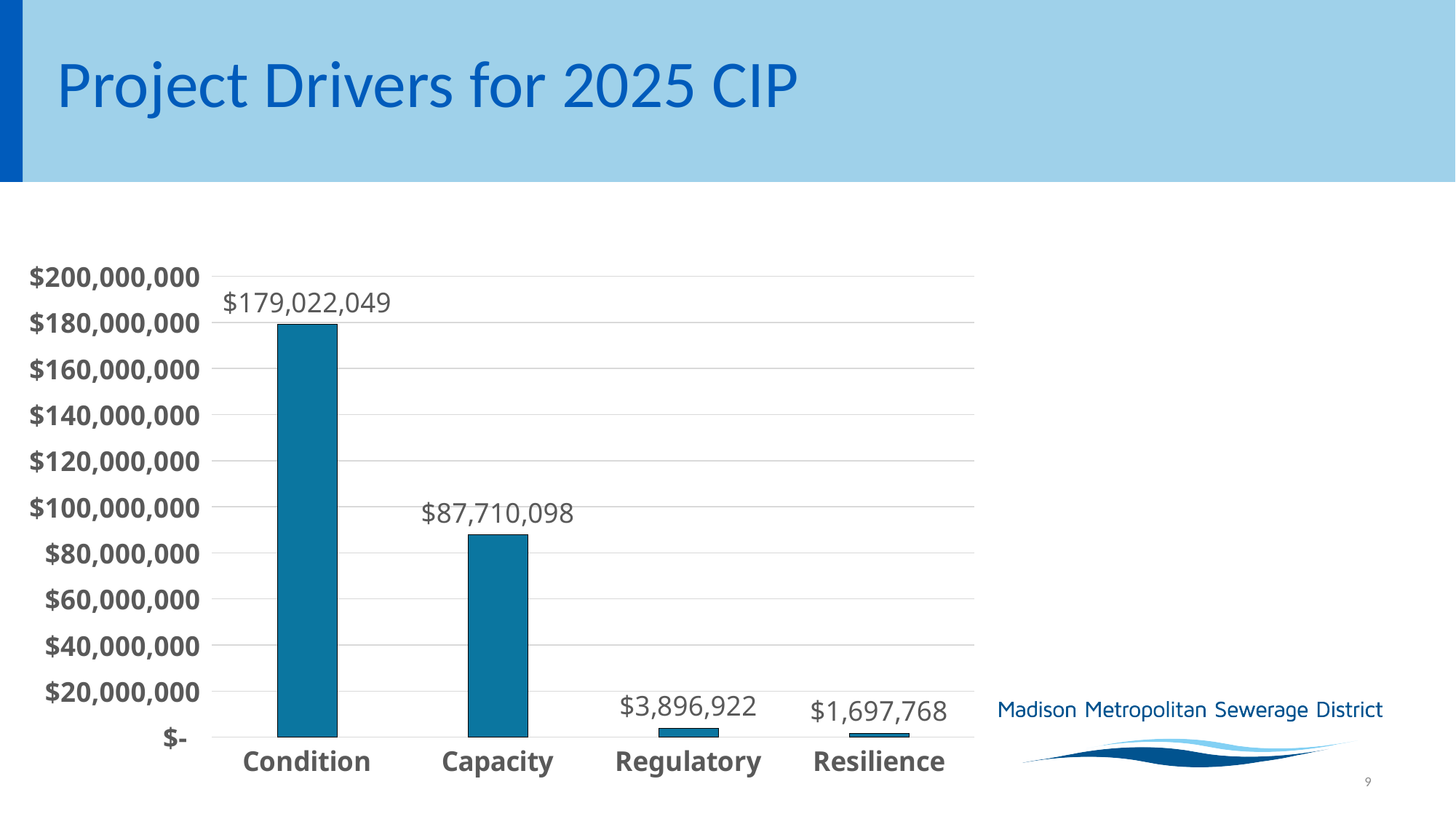
What is the value for Regulatory? $3,896,922 Is the value for Capacity greater or less than $100,000,000? less What kind of chart is shown on the slide? bar chart Which project driver has the highest value? Condition What is the value for Condition? $179,022,049 Which project driver has the lowest value? Resilience What is the difference between the values for Regulatory and Resilience? $2,199,154 What is the value for Resilience? $1,697,768 Which is larger, the value for Capacity or the value for Regulatory? Capacity What is the value for Capacity? $87,710,098 What is the difference between the values for Condition and Capacity? $91,311,951 How many project driver categories are shown on the chart? 4